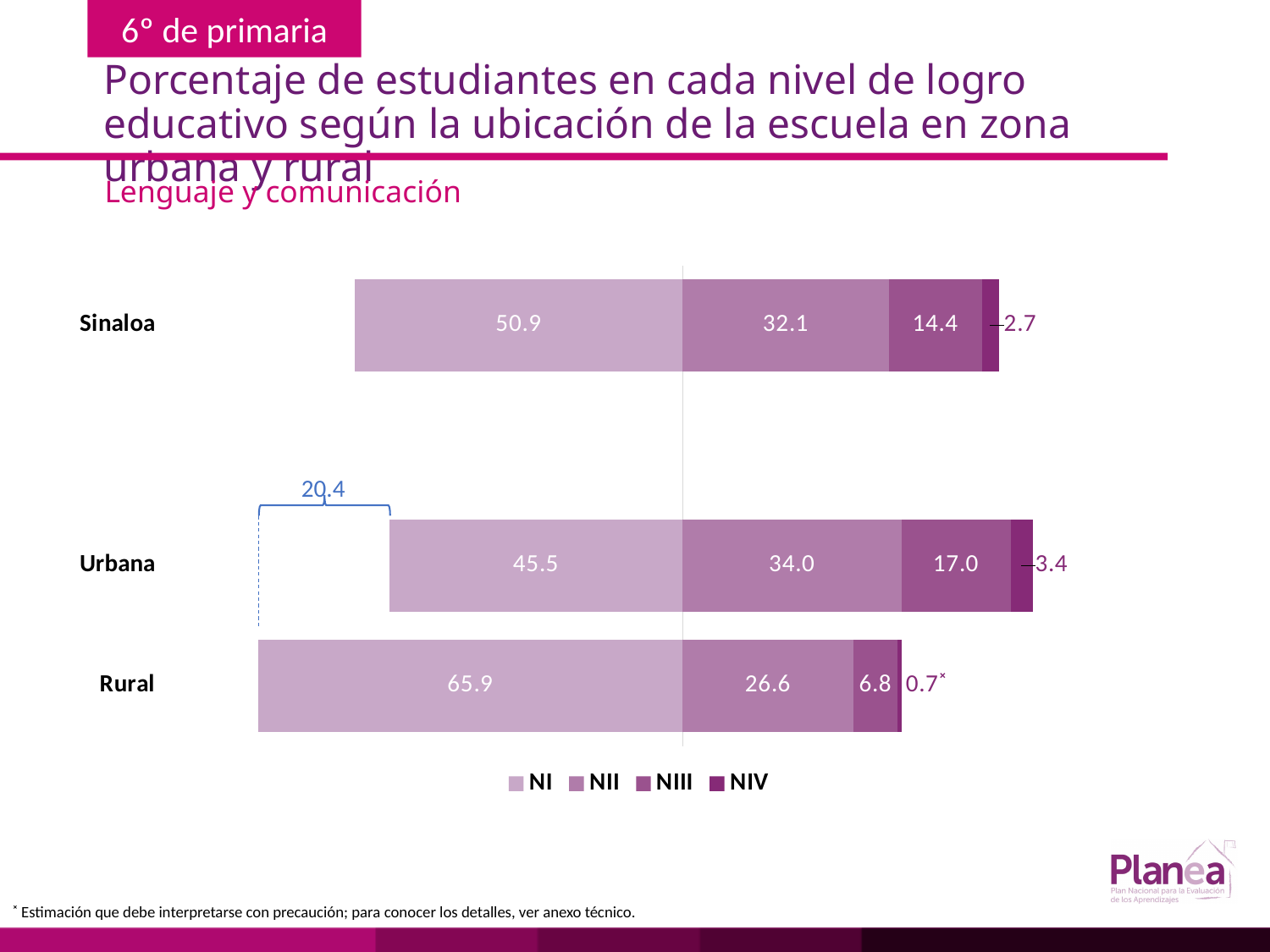
What is the NI value for Rural? 65.9 How many categories are shown on the chart? 3 How many series does the legend list? 4 What is the NIII value for Sinaloa? 14.4 What kind of chart is shown on the slide? Stacked bar chart What is the difference between the NI values for Rural and Urbana? 20.4 What is the NII value for Urbana? 34.0 Which category has the lowest NIII value? Rural What is the NIV value for Urbana? 3.4 Which is larger, the NII value for Sinaloa or the NII value for Rural? Sinaloa What is the subject area named below the chart title? Lenguaje y comunicación Which category has the highest NI value? Rural